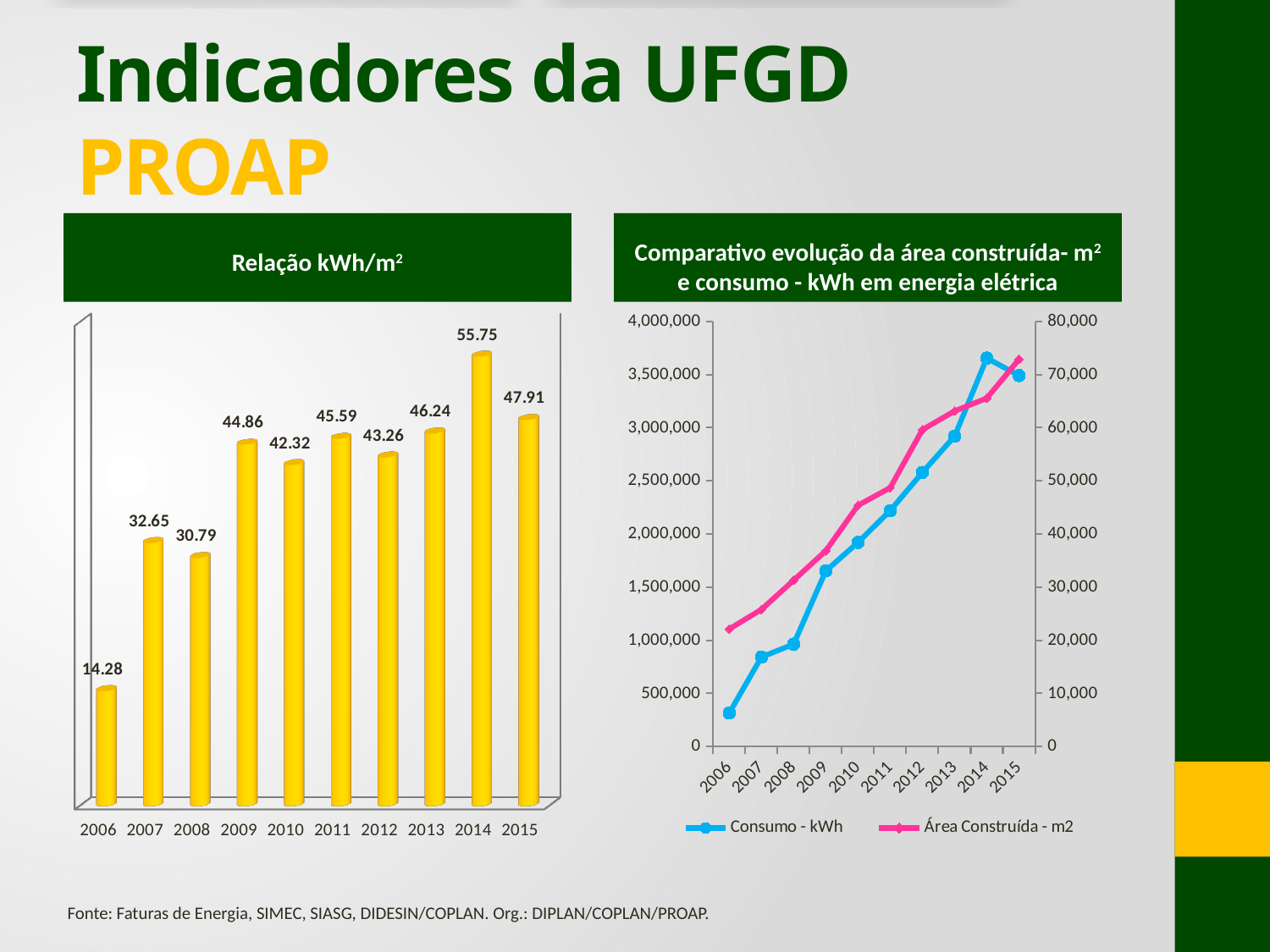
In the 'Relação kWh/m²' chart, what is the value for 2006? 14.28 In the 'Relação kWh/m²' chart, which year has the lowest value? 2006 In the 'Comparativo evolução da área construída' chart, how many series does the legend list? 2 What kind of chart is the 'Relação kWh/m²' chart? Bar chart In the 'Relação kWh/m²' chart, which is larger, the value for 2007 or the value for 2008? 2007 In the 'Comparativo evolução da área construída' chart, is the value of 'Consumo - kWh' for 2006 greater or less than 500,000? less In the 'Relação kWh/m²' chart, what is the value for 2014? 55.75 In the 'Comparativo evolução da área construída' chart, which colour is the 'Consumo - kWh' line? Blue In the 'Relação kWh/m²' chart, what is the difference between the values for 2014 and 2015? 7.84 In the 'Relação kWh/m²' chart, how many years are shown? 10 In the 'Relação kWh/m²' chart, which year has the highest value? 2014 In the 'Comparativo evolução da área construída' chart, does 'Área Construída - m2' generally rise or fall from 2006 to 2015? rise